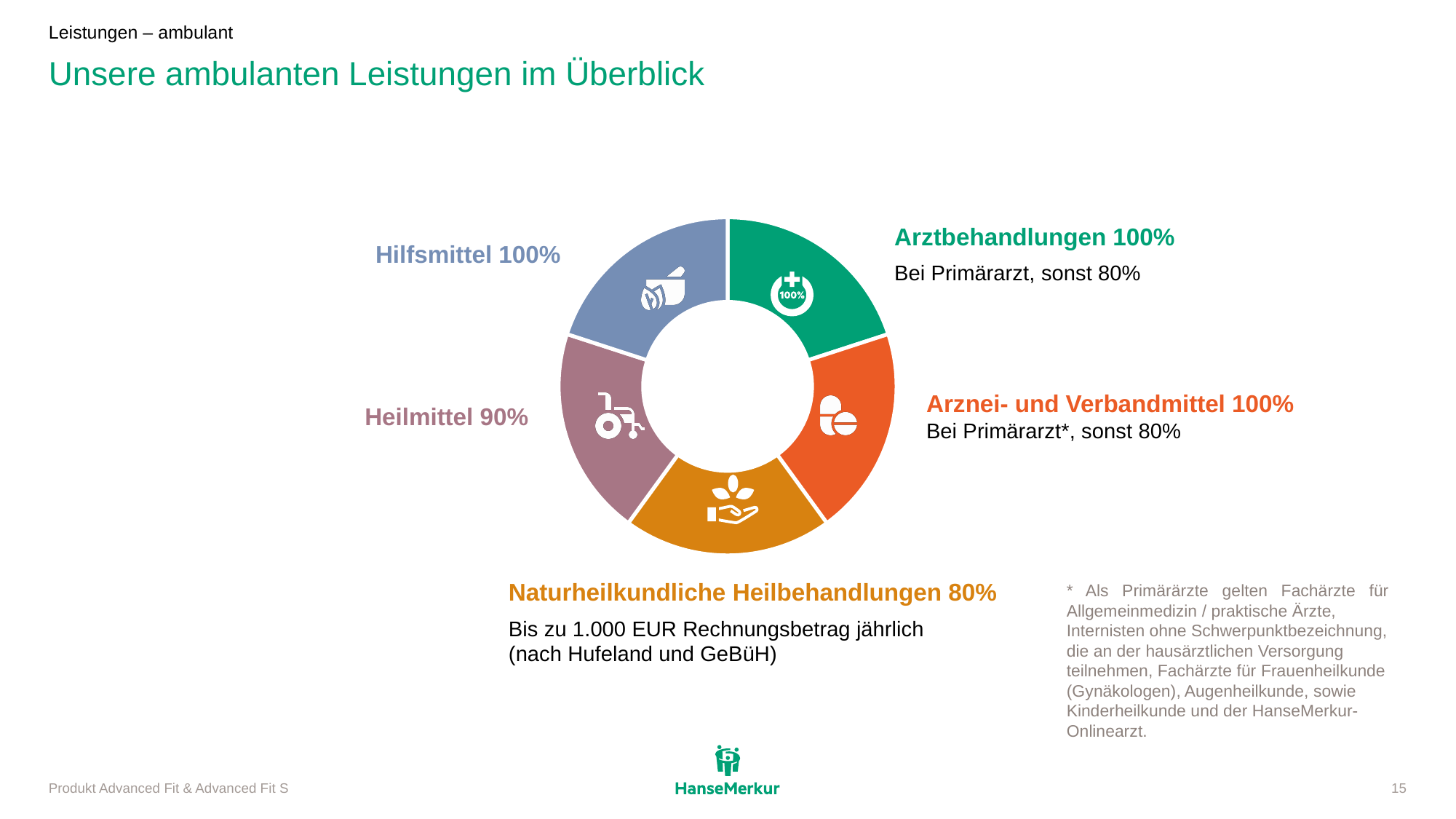
What is the difference between the percentage for Hilfsmittel and the percentage for Heilmittel? 10% What colour is the Arznei- und Verbandmittel segment of the donut chart? Orange-red What percentage is shown for Arznei- und Verbandmittel? 100% Which category has the lowest percentage shown? Naturheilkundliche Heilbehandlungen What percentage is shown for Naturheilkundliche Heilbehandlungen? 80% What percentage is shown for Hilfsmittel? 100% What is the difference between the percentage for Arztbehandlungen and the percentage for Naturheilkundliche Heilbehandlungen? 20% Which has a higher percentage, Heilmittel or Naturheilkundliche Heilbehandlungen? Heilmittel What percentage is shown for Heilmittel? 90% What percentage is shown for Arztbehandlungen? 100% What kind of chart is shown on the slide? Donut (pie) chart How many segments does the donut chart have? 5